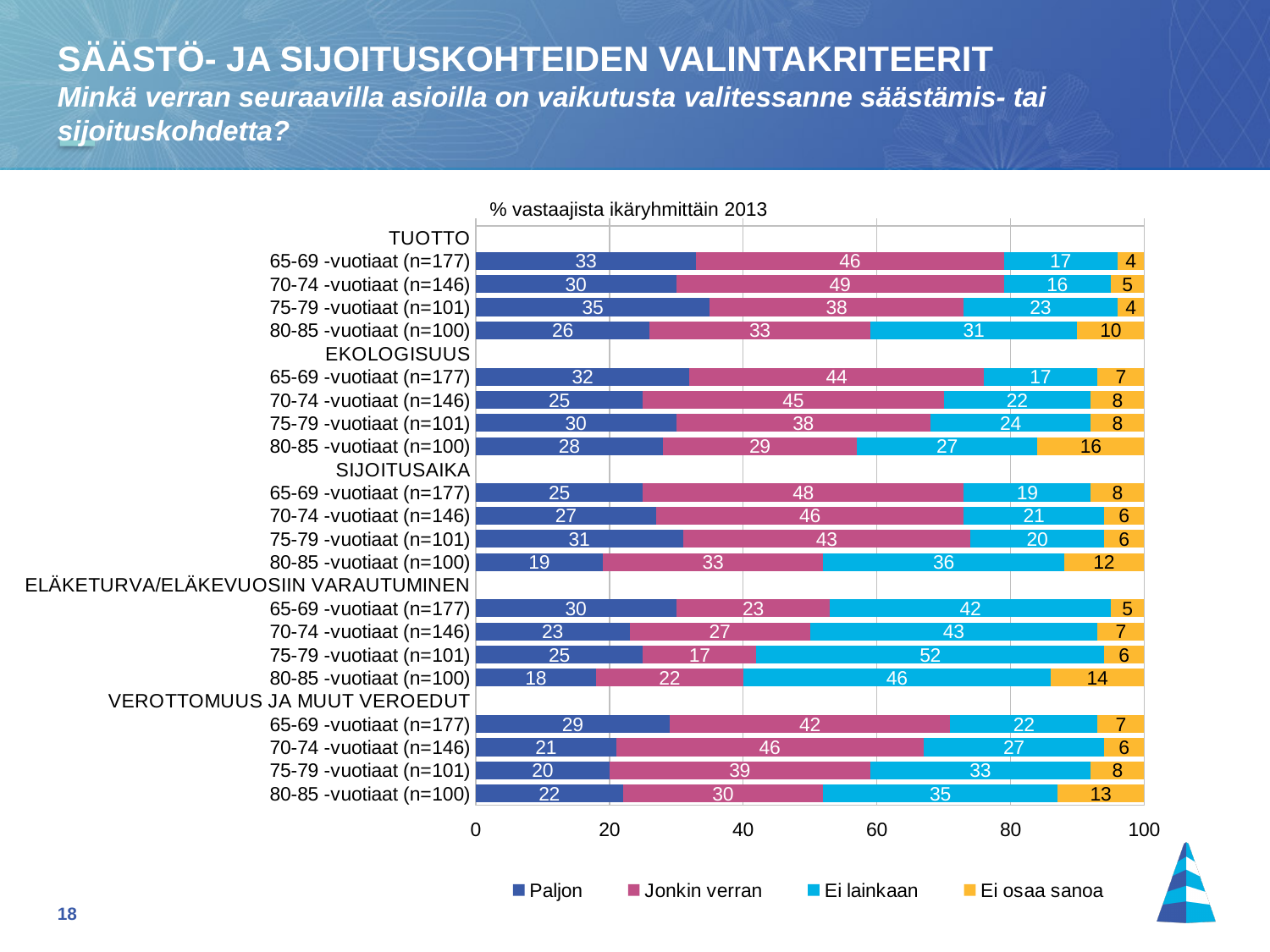
What is the difference between the 'Jonkin verran' values for 70-74 -vuotiaat and 80-85 -vuotiaat under TUOTTO? 16 What kind of chart is shown on the slide? Stacked bar chart Under VEROTTOMUUS JA MUUT VEROEDUT, is the 'Ei lainkaan' value larger for 75-79 -vuotiaat or for 65-69 -vuotiaat? 75-79 -vuotiaat Which age group has the highest 'Paljon' value under TUOTTO? 75-79 -vuotiaat (n=101) How many bars are plotted in the chart in total? 20 How many series does the legend list? 4 What is the 'Paljon' value for 65-69 -vuotiaat under TUOTTO? 33 What is the title shown above the chart? % vastaajista ikäryhmittäin 2013 What is the 'Ei osaa sanoa' value for 80-85 -vuotiaat under EKOLOGISUUS? 16 What is the total of the stacked bar for 65-69 -vuotiaat under TUOTTO? 100 What is the 'Ei lainkaan' value for 75-79 -vuotiaat under ELÄKETURVA/ELÄKEVUOSIIN VARAUTUMINEN? 52 Which age group has the lowest 'Paljon' value under ELÄKETURVA/ELÄKEVUOSIIN VARAUTUMINEN? 80-85 -vuotiaat (n=100)